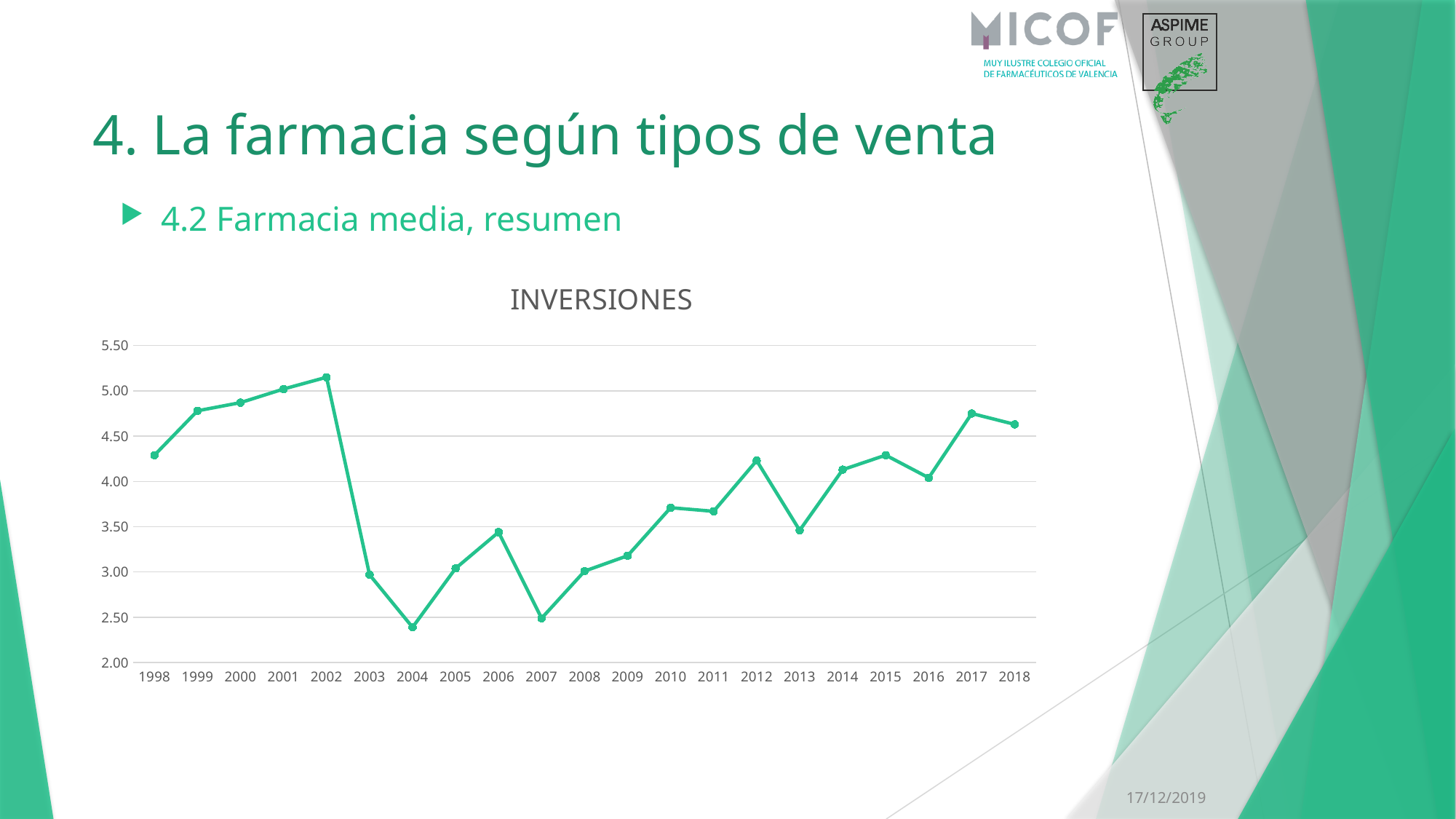
What is the title of the chart? INVERSIONES Is the value for 2017 greater or less than 4.50? greater Is the value for 2004 greater or less than 2.50? less How many years are plotted on the x axis of the chart? 21 Is the value for 2012 greater or less than 4.00? greater Which year has the highest value in the chart? 2002 Which year has the lowest value in the chart? 2004 Do the values rise or fall from 1998 to 2002? rise What kind of chart is shown on the slide? line chart Which year has the larger value, 2016 or 2017? 2017 Which year has the larger value, 2002 or 2003? 2002